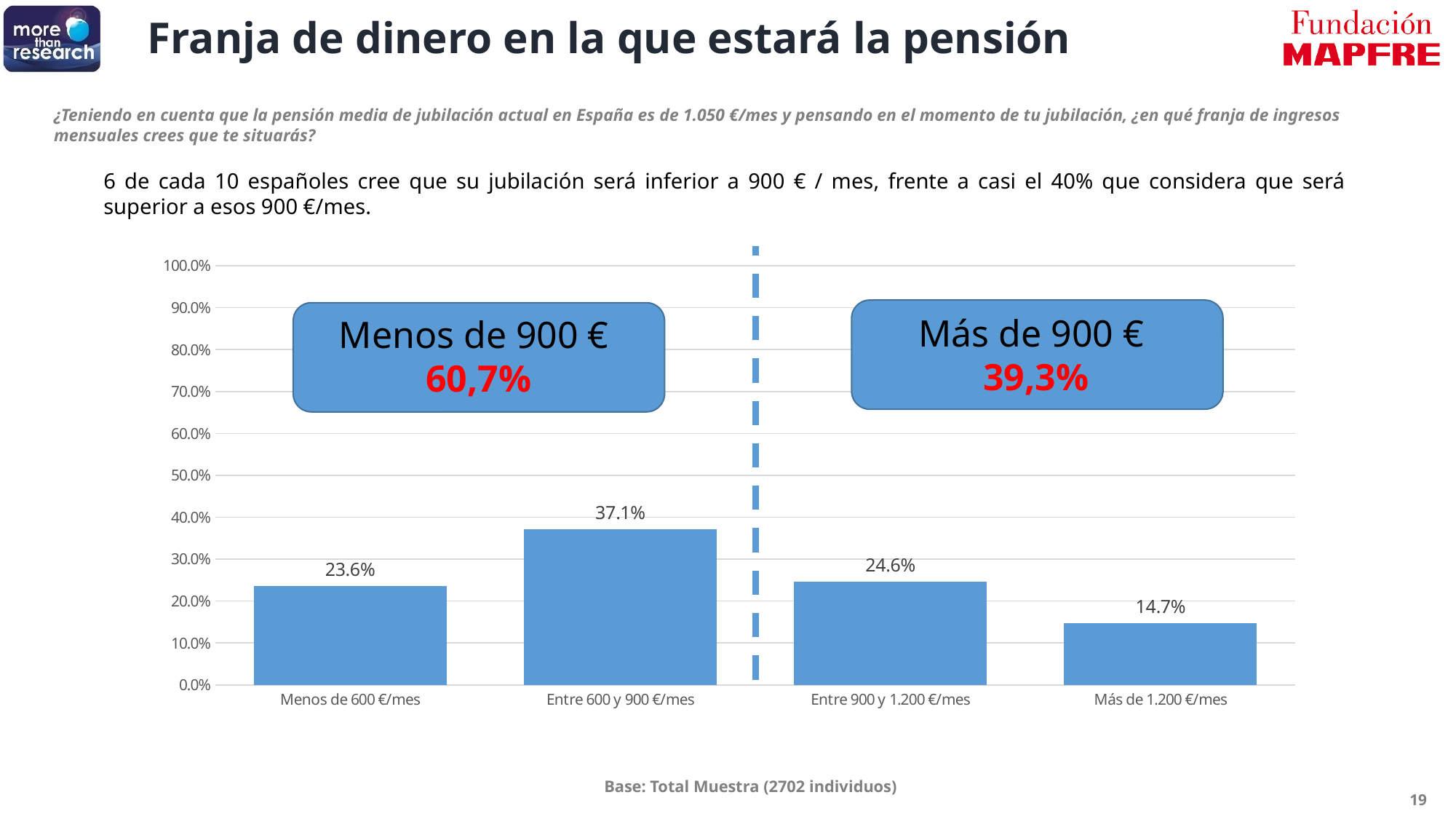
Is the value for "Entre 600 y 900 €/mes" greater or less than 30.0%? greater Which category has the highest value? Entre 600 y 900 €/mes What is the difference between the values for "Entre 600 y 900 €/mes" and "Entre 900 y 1.200 €/mes"? 12.5% Which is larger, the value for "Menos de 600 €/mes" or the value for "Entre 900 y 1.200 €/mes"? Entre 900 y 1.200 €/mes What is the value for "Menos de 600 €/mes"? 23.6% What percentage is shown in the box labelled "Más de 900 €"? 39,3% What kind of chart is shown on the slide? bar chart What is the value for "Entre 600 y 900 €/mes"? 37.1% What is the value for "Más de 1.200 €/mes"? 14.7% Which category has the lowest value? Más de 1.200 €/mes How many categories are shown on the x axis? 4 What percentage is shown in the box labelled "Menos de 900 €"? 60,7%